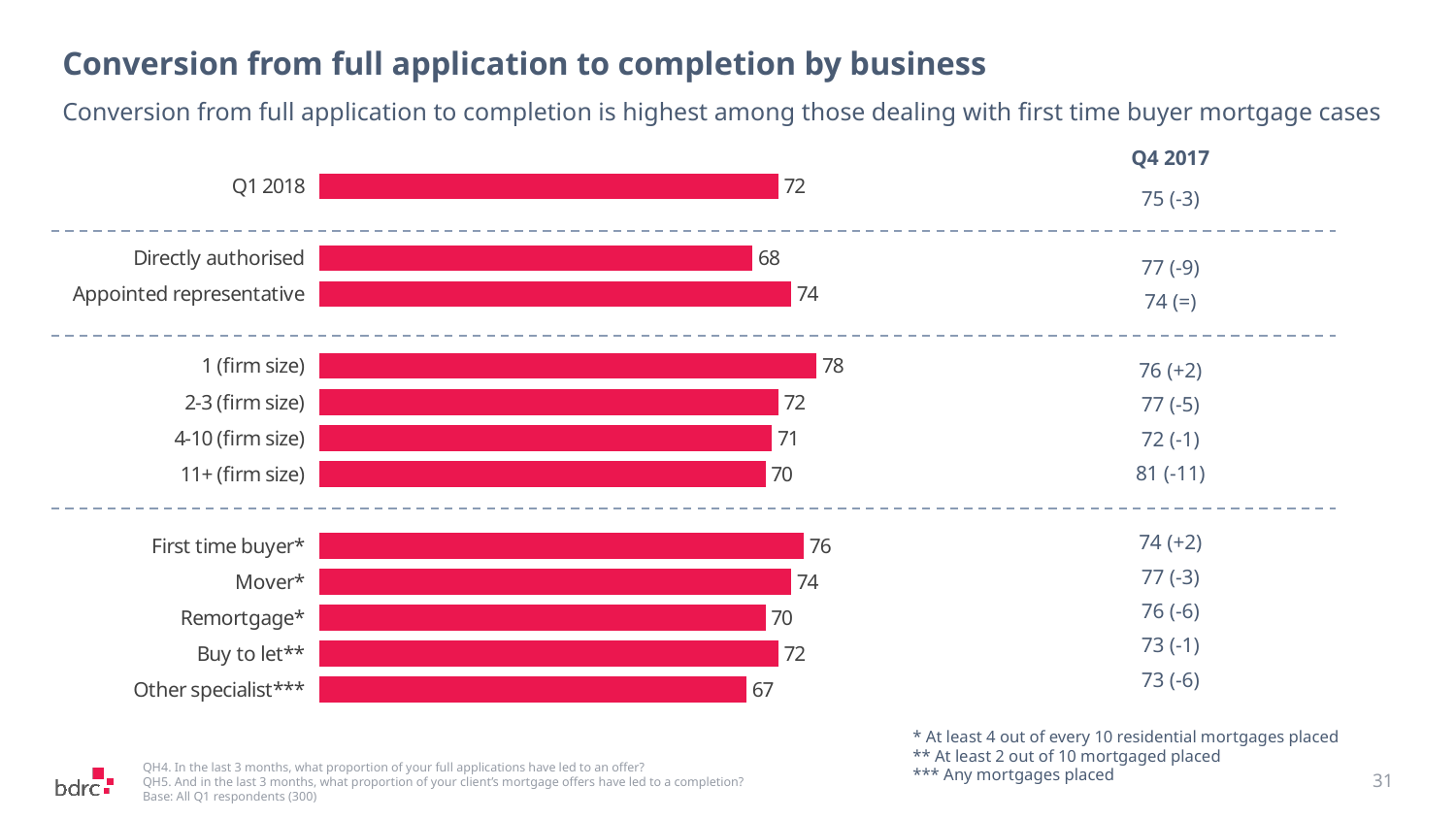
What is the value for Directly authorised? 68 How many bars are plotted in the chart? 12 What is the value for First time buyer*? 76 Which category has the lowest value? Other specialist*** What kind of chart is shown on the slide? Bar chart Which category has the highest value? 1 (firm size) What is the value for 4-10 (firm size)? 71 What is the title of the chart on the slide? Conversion from full application to completion by business Which is larger, the value for Mover* or the value for Remortgage*? Mover* What is the Q4 2017 value shown for 11+ (firm size)? 81 (-11) What is the difference between the values for 1 (firm size) and 11+ (firm size)? 8 What is the difference between the values for Appointed representative and Directly authorised? 6